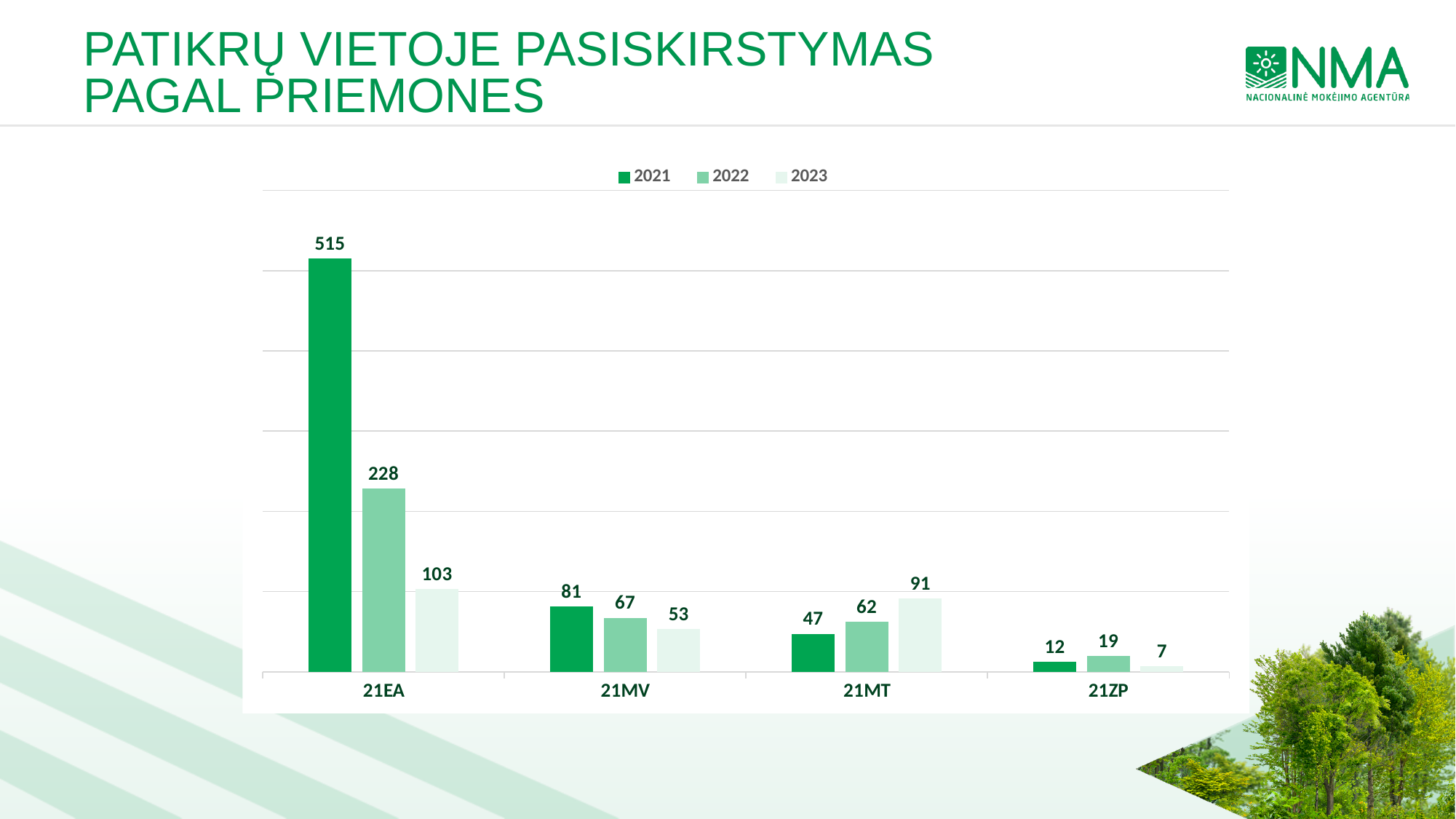
Which category has the lowest value in 2023? 21ZP What is the value for 21MT in 2023? 91 Do the values for 21MT rise or fall from 2021 to 2023? Rise Which years are listed in the legend? 2021, 2022, 2023 What is the value for 21EA in 2021? 515 What is the value for 21ZP in 2022? 19 What kind of chart is shown on the slide? Bar chart What is the difference between the 2021 and 2022 values for 21EA? 287 Which category has the highest value in 2021? 21EA Which is larger for 21MV: the 2022 value or the 2023 value? 2022 How many series does the legend list? 3 How many categories are shown on the x axis? 4